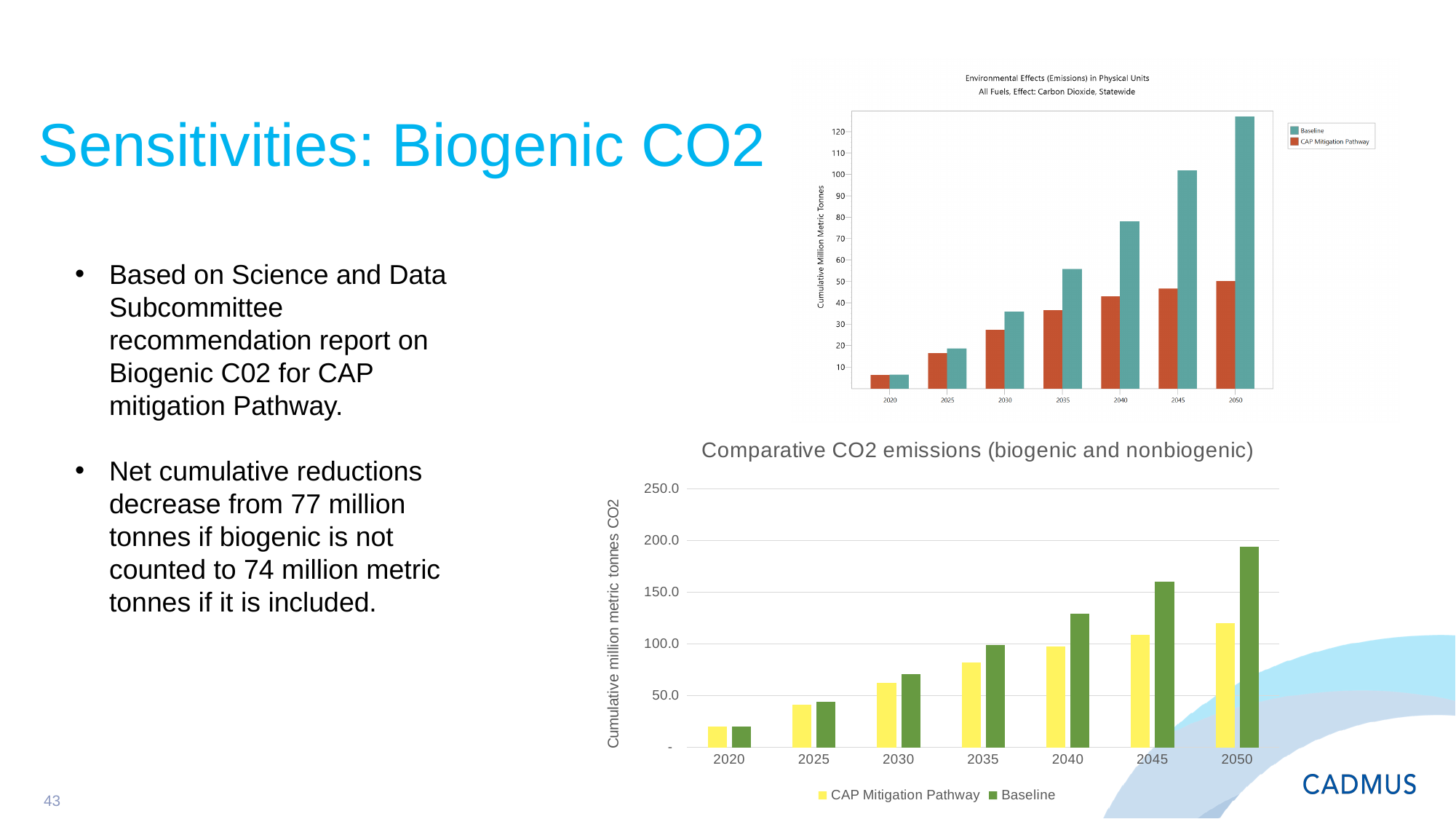
In the bottom chart titled 'Comparative CO2 emissions (biogenic and nonbiogenic)', is the Baseline value for 2045 greater or less than 150.0? greater In the bottom chart titled 'Comparative CO2 emissions (biogenic and nonbiogenic)', which is larger in 2040, the Baseline value or the CAP Mitigation Pathway value? Baseline In the bottom chart titled 'Comparative CO2 emissions (biogenic and nonbiogenic)', is the Baseline value for 2050 greater or less than 200.0? less In the bottom chart titled 'Comparative CO2 emissions (biogenic and nonbiogenic)', which year has the highest Baseline value? 2050 In the bottom chart titled 'Comparative CO2 emissions (biogenic and nonbiogenic)', how many series does the legend list? 2 In the top chart titled 'Environmental Effects (Emissions) in Physical Units', is the Baseline value for 2050 greater or less than 120? greater In the bottom chart titled 'Comparative CO2 emissions (biogenic and nonbiogenic)', how many years are shown on the x axis? 7 In the bottom chart titled 'Comparative CO2 emissions (biogenic and nonbiogenic)', do the Baseline values rise or fall from 2020 to 2050? rise In the bottom chart titled 'Comparative CO2 emissions (biogenic and nonbiogenic)', what kind of chart is shown? bar chart In the top chart titled 'Environmental Effects (Emissions) in Physical Units', which year has the lowest CAP Mitigation Pathway value? 2020